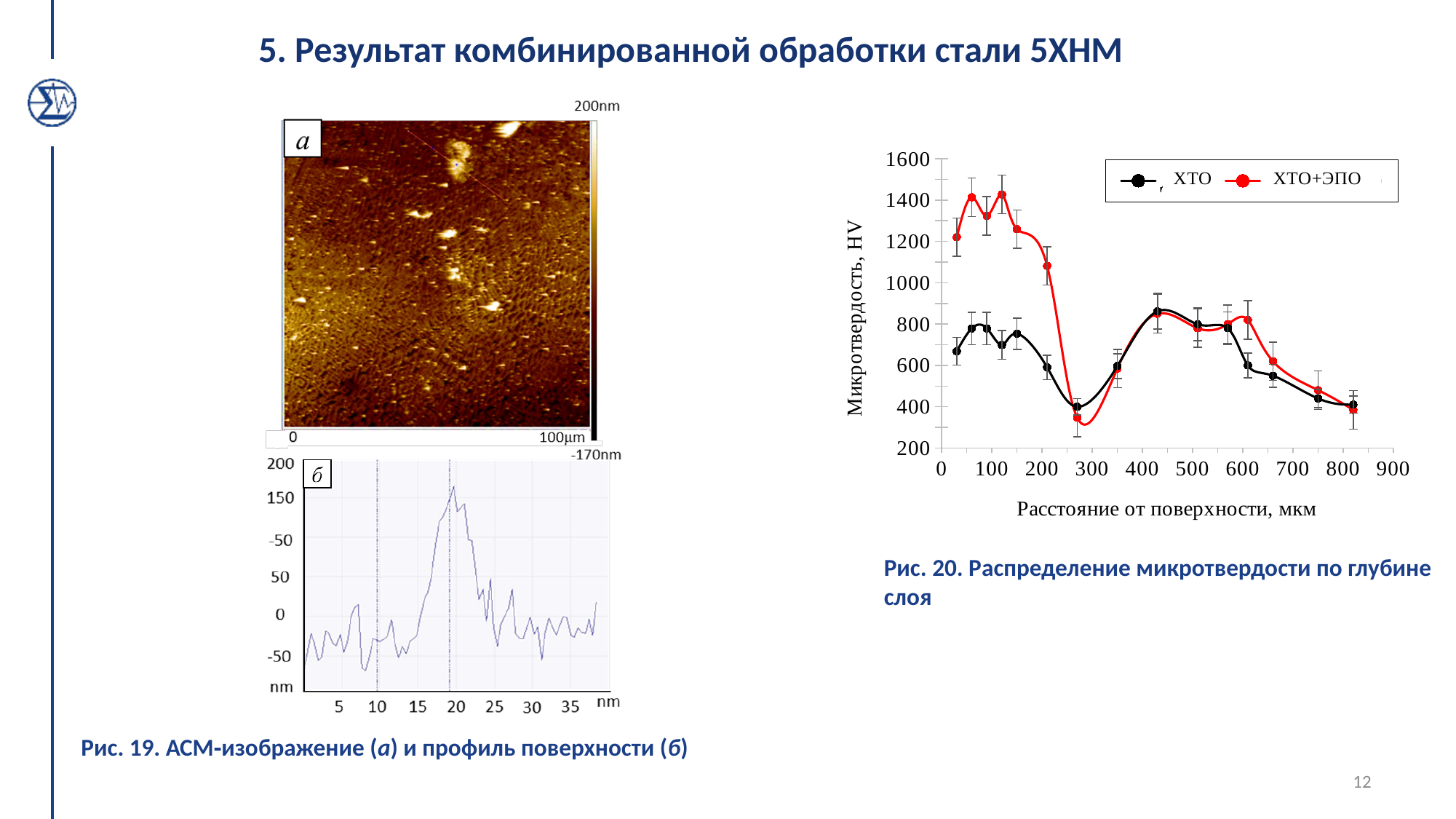
In the chart of Рис. 20, which series has the higher value at about 600 мкм from the surface, ХТО or ХТО+ЭПО? ХТО+ЭПО In the chart of Рис. 20, which series reaches the highest microhardness value overall? ХТО+ЭПО In the chart of Рис. 20, which series has the higher value at about 100 мкм from the surface, ХТО or ХТО+ЭПО? ХТО+ЭПО In the chart of Рис. 20, is the value of the ХТО+ЭПО series at its first point near the surface greater or less than 1000? greater In the chart of Рис. 20, is the value of the ХТО series at about 430 мкм greater or less than 800? greater In the chart of Рис. 20, does the ХТО+ЭПО series rise or fall between about 100 мкм and 300 мкм from the surface? fall In the chart of Рис. 20, what are the two series named in the legend? ХТО and ХТО+ЭПО What kind of chart is Рис. 20 (Распределение микротвердости по глубине слоя)? Line chart In the chart of Рис. 20, what is the title of the horizontal axis? Расстояние от поверхности, мкм In the chart of Рис. 20, how many series does the legend list? 2 In the chart of Рис. 20, is the minimum value of the ХТО+ЭПО series (near 300 мкм) greater or less than 400? less